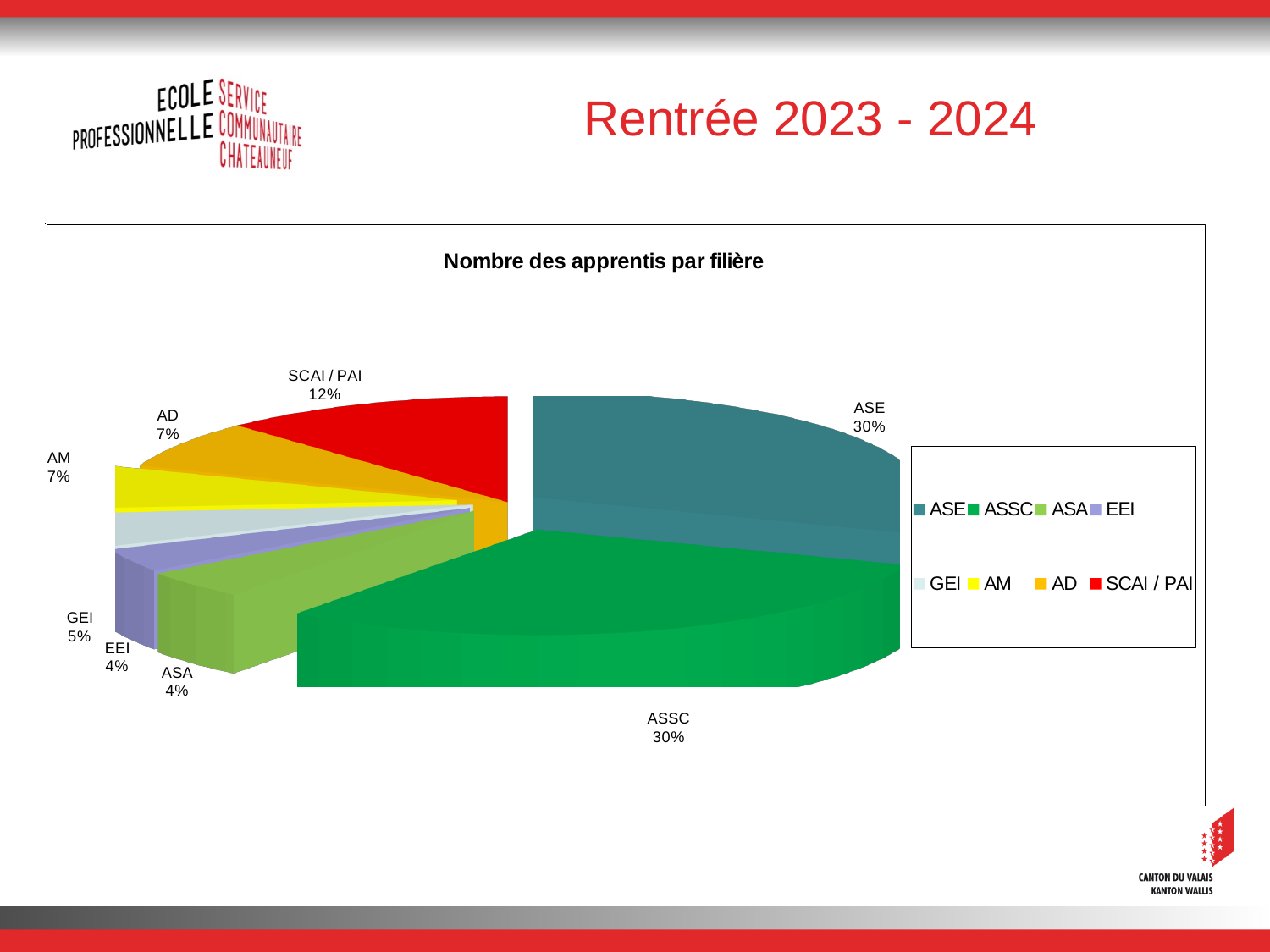
How many slices does the pie chart have? 8 What kind of chart is shown on the slide? Pie chart What percentage is shown for AD? 7% What is the difference in percentage points between SCAI / PAI and AM? 5 What share of the pie does ASE represent? 30% What share of the pie does ASSC represent? 30% What percentage is shown for EEI? 4% What colour is the ASSC slice in the pie chart? Green What percentage is shown for GEI? 5% What is the title of the chart? Nombre des apprentis par filière Which slice is larger, SCAI / PAI or AD? SCAI / PAI What percentage is shown for SCAI / PAI? 12%